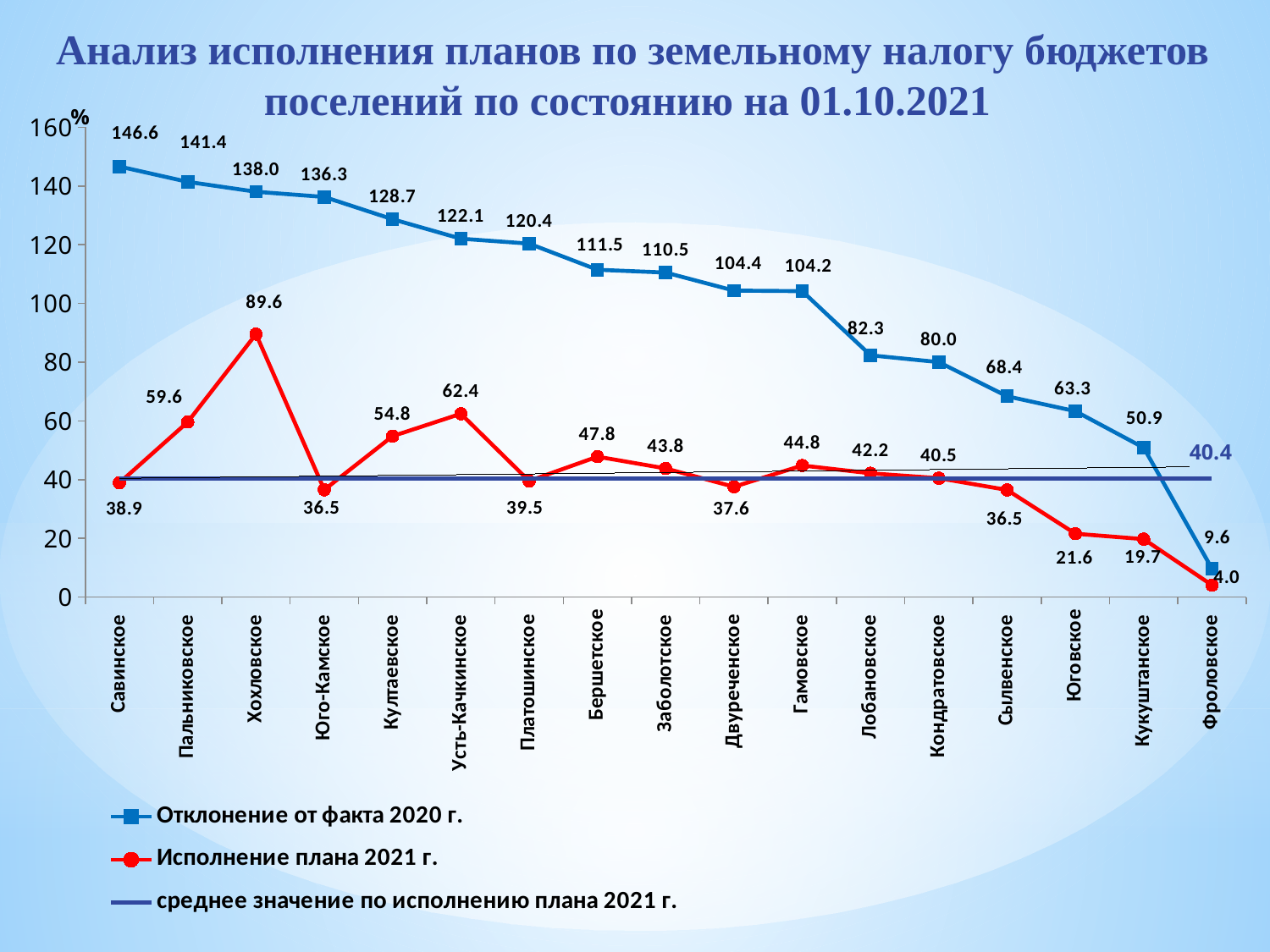
What is the value of 'Исполнение плана 2021 г.' for Хохловское? 89.6 What type of chart is shown on the slide? line chart Which settlement has the highest value for 'Исполнение плана 2021 г.'? Хохловское Does the 'Отклонение от факта 2020 г.' series generally rise or fall from left to right along the x axis? fall What is the value of the average line 'среднее значение по исполнению плана 2021 г.'? 40.4 Which settlement has the lowest value for 'Отклонение от факта 2020 г.'? Фроловское How many series does the legend list? 3 What is the value of 'Отклонение от факта 2020 г.' for Култаевское? 128.7 What is the difference between the 'Отклонение от факта 2020 г.' values for Савинское and Пальниковское? 5.2 What colour is the line for 'Исполнение плана 2021 г.'? red How many settlements are shown on the x axis? 17 Which is larger for Усть-Качкинское: 'Отклонение от факта 2020 г.' or 'Исполнение плана 2021 г.'? Отклонение от факта 2020 г.